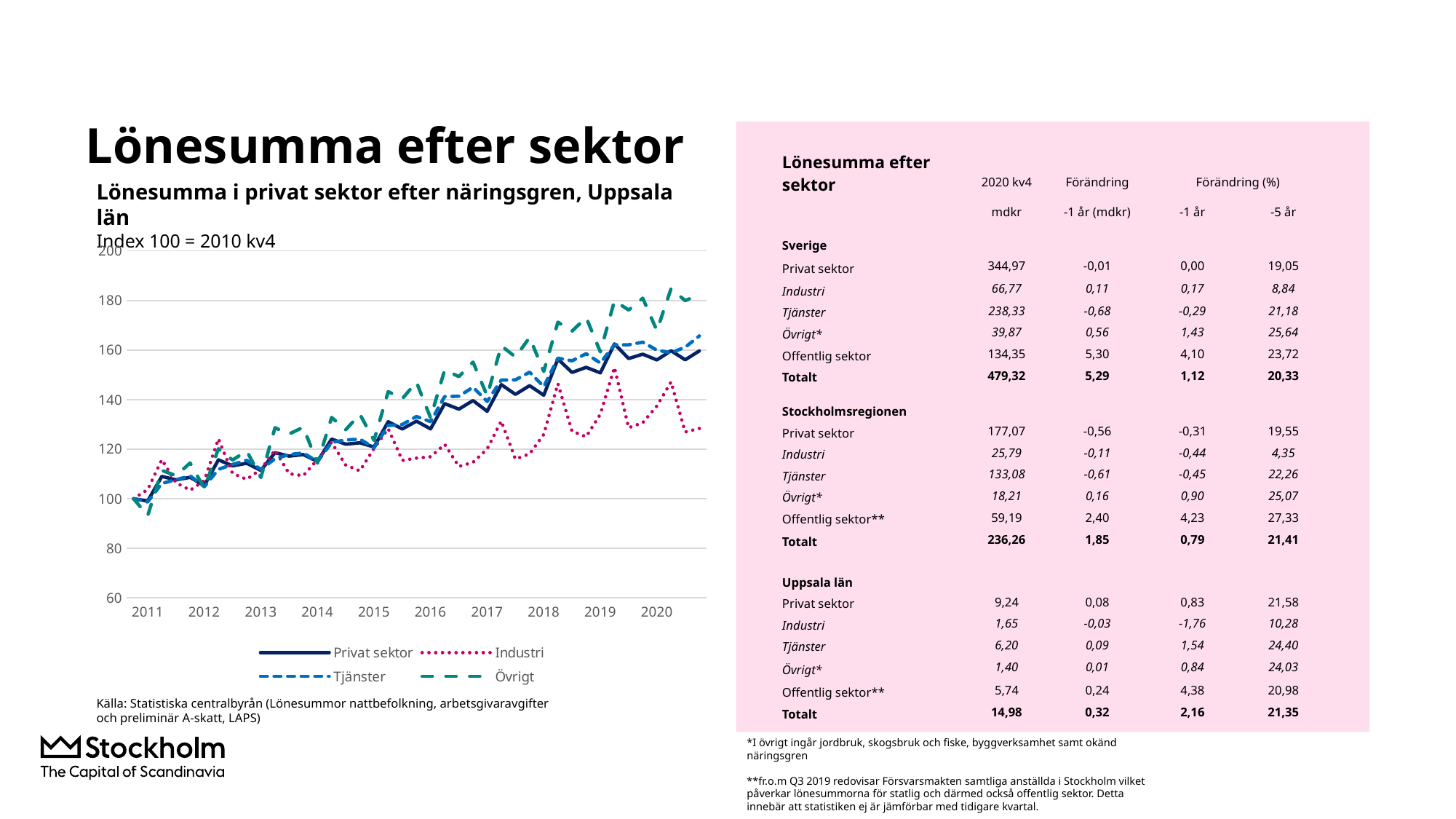
Is the value for Tjänster at the end of 2020 greater or less than 140? greater What kind of chart is shown on the slide? line chart Is the value for Industri at the end of 2020 greater or less than 140? less Is the value for Övrigt at the end of 2020 greater or less than 160? greater How many series does the chart legend list? 4 Does the Privat sektor series rise or fall from 2011 to 2020? rise How many years are labelled on the x axis of the chart? 10 Which series is highest at the end of the chart in 2020? Övrigt At the end of 2020, which is higher, Övrigt or Industri? Övrigt Which series is lowest at the end of the chart in 2020? Industri What is the title of the chart? Lönesumma i privat sektor efter näringsgren, Uppsala län